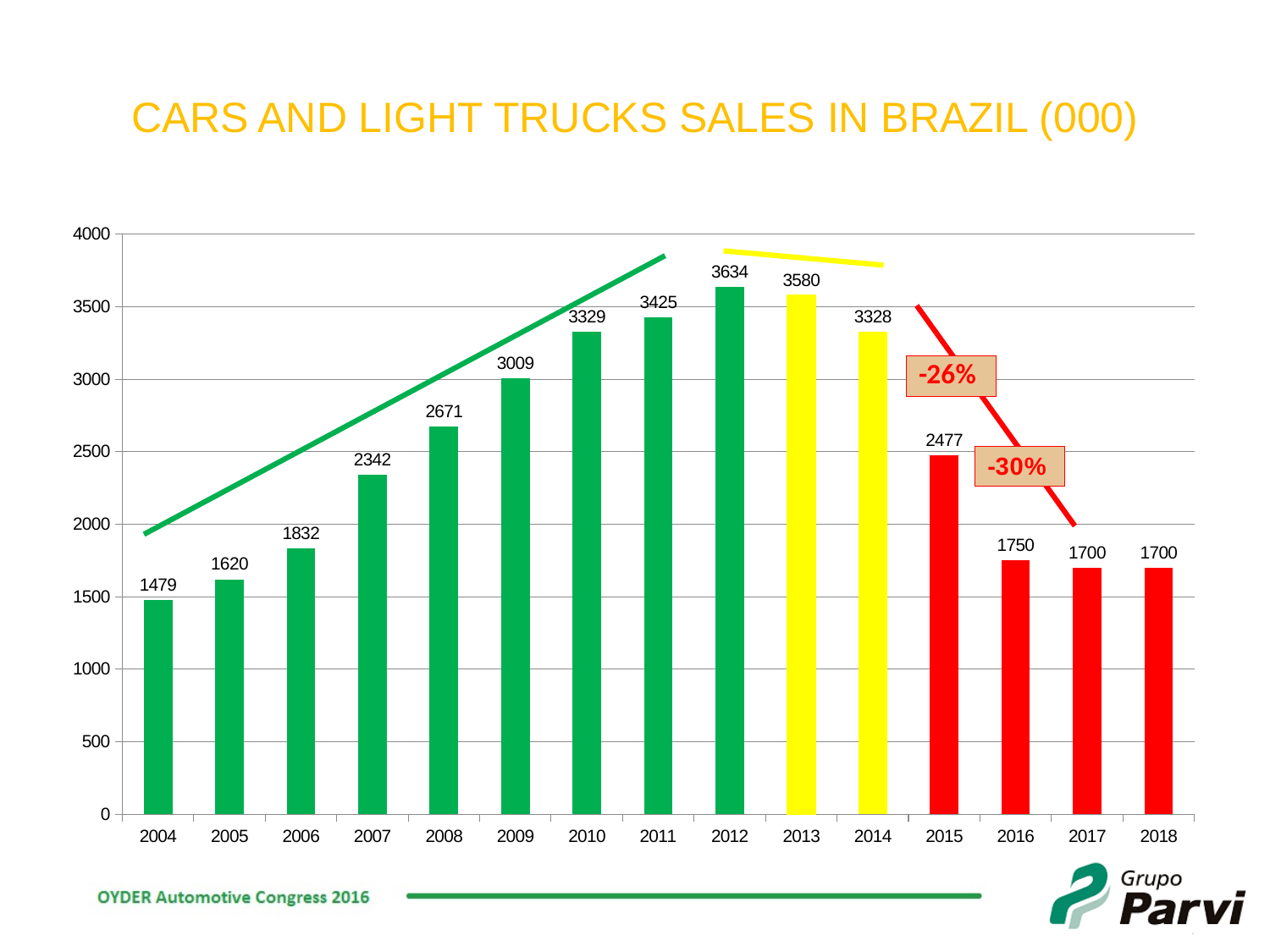
What is the difference between the values for 2014 and 2015? 851 What is the value for 2012? 3634 What is the value for 2015? 2477 What is the value for 2004? 1479 Which is larger, the value for 2013 or the value for 2011? 2013 Do the values rise or fall from 2004 to 2012? rise What is the title of the chart? CARS AND LIGHT TRUCKS SALES IN BRAZIL (000) Is the value for 2009 greater or less than 3000? greater Which year has the highest value? 2012 Which year has the lowest value? 2004 What kind of chart is this? bar chart How many years are shown on the x axis? 15